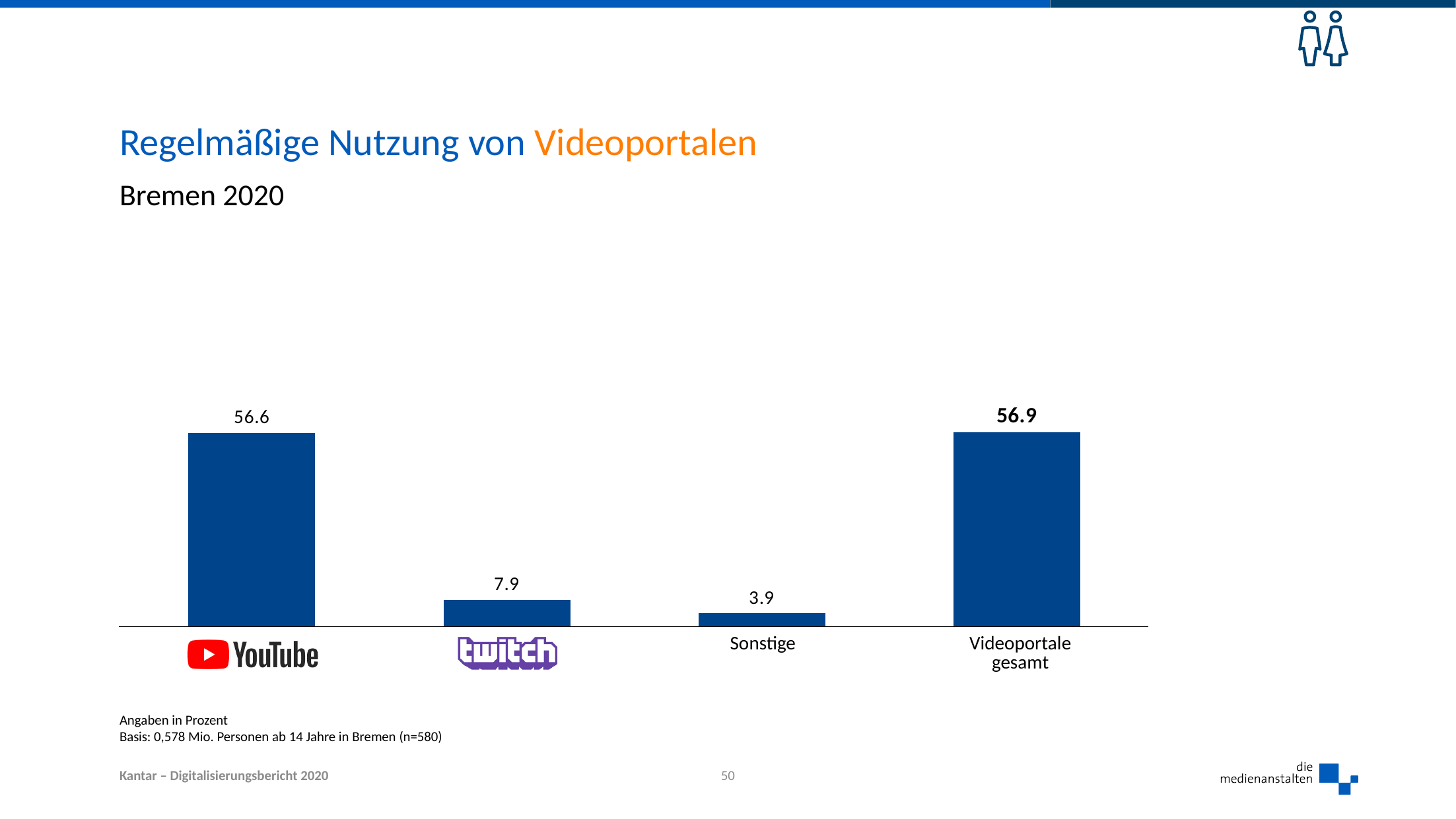
What is the value for Twitch? 7.9 What kind of chart is shown on the slide? bar chart Which is larger, the value for Twitch or the value for Sonstige? Twitch Which category has the lowest value? Sonstige What is the difference between the values for YouTube and Twitch? 48.7 What is the value for Videoportale gesamt? 56.9 How many categories are shown in the chart? 4 What is the difference between the values for Twitch and Sonstige? 4.0 What unit are the values given in, according to the note below the chart? Prozent What is the value for Sonstige? 3.9 What is the value for YouTube? 56.6 Which category has the highest value? Videoportale gesamt